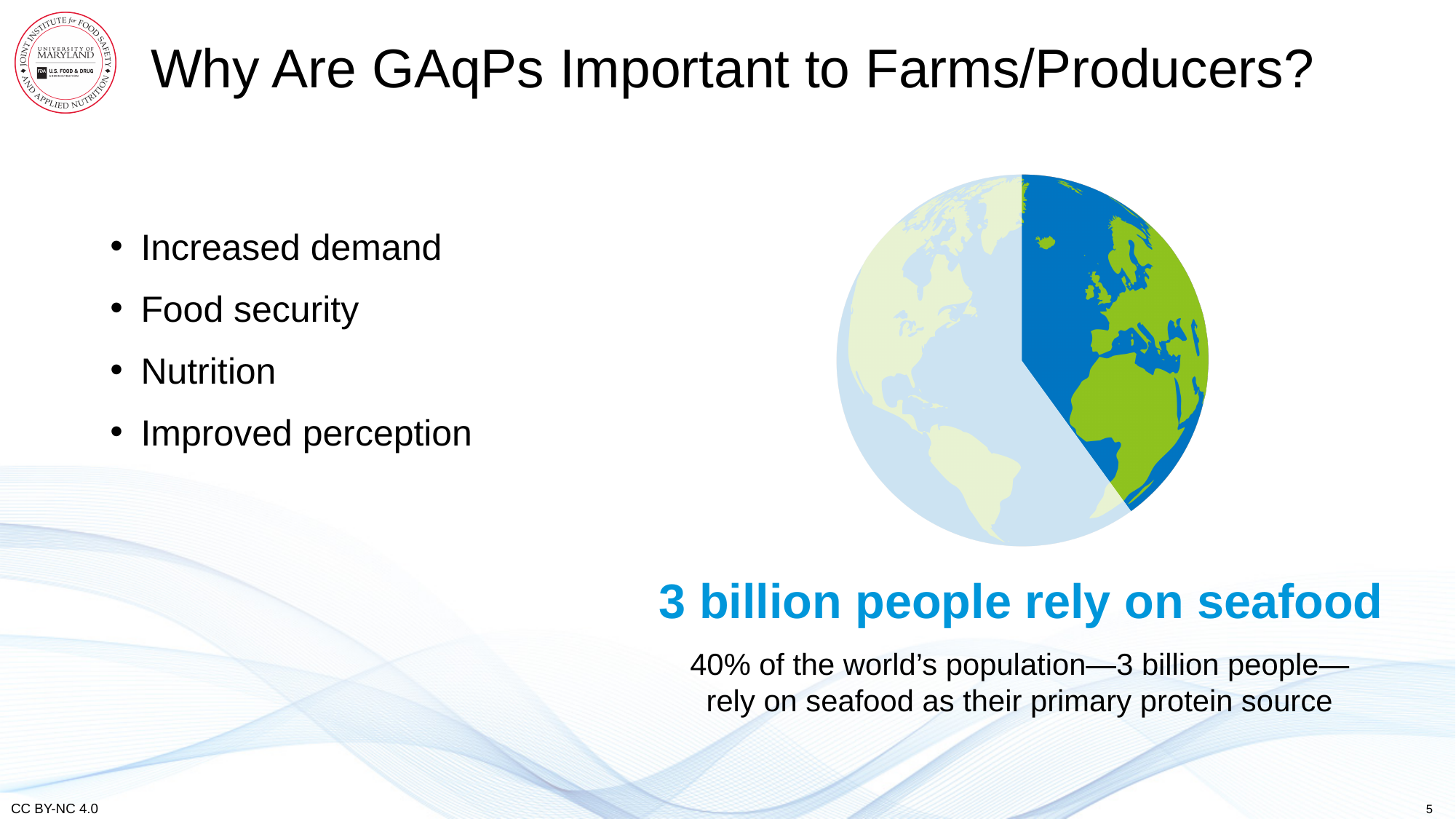
What kind of chart is the globe graphic styled as? pie chart How many people does the highlighted portion of the globe correspond to? 3 billion What share of the world's population does the highlighted (bright) portion of the globe represent? 40% What does the highlighted portion of the globe represent? People who rely on seafood as their primary protein source Which portion of the globe is larger, the highlighted portion or the faded portion? the faded portion Is the share of the world's population shown by the highlighted portion of the globe greater or less than 50%? less What share of the world's population does the faded portion of the globe represent? 60%